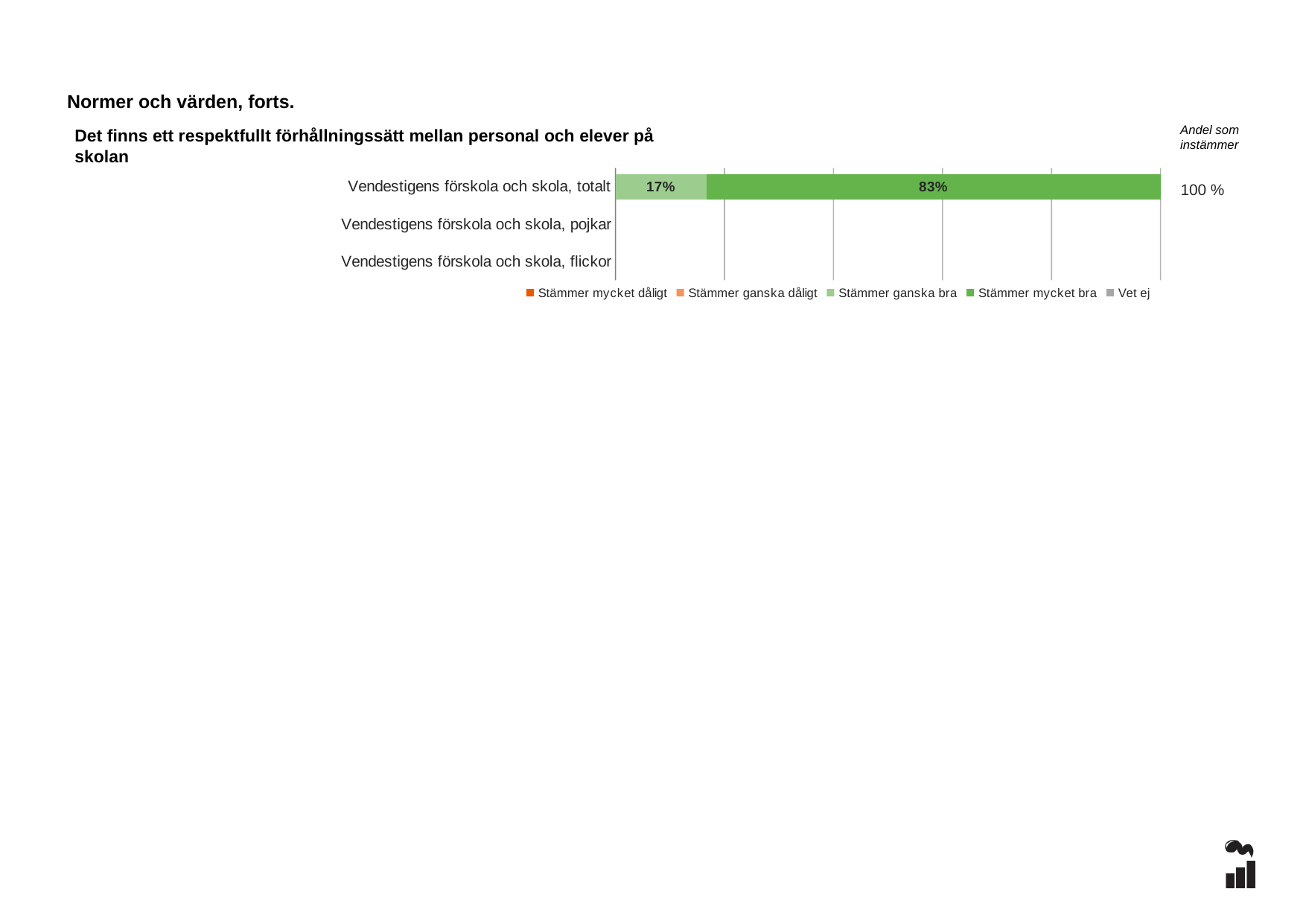
Which is larger for Vendestigens förskola och skola, totalt: "Stämmer ganska bra" or "Stämmer mycket bra"? Stämmer mycket bra What is the total of the stacked bar for Vendestigens förskola och skola, totalt? 100% What is the value for "Stämmer ganska bra" for Vendestigens förskola och skola, totalt? 17% What is the value for "Stämmer mycket bra" for Vendestigens förskola och skola, totalt? 83% How many categories are shown on the vertical axis of the chart? 3 What is the difference between the "Stämmer mycket bra" and "Stämmer ganska bra" values for Vendestigens förskola och skola, totalt? 66% Which legend entry is shown in the darkest green colour? Stämmer mycket bra What is the title of the chart? Det finns ett respektfullt förhållningssätt mellan personal och elever på skolan What kind of chart is shown on the slide? bar chart Which category has the largest "Stämmer mycket bra" segment? Vendestigens förskola och skola, totalt How many series does the legend list? 5 What is the "Andel som instämmer" value shown for Vendestigens förskola och skola, totalt? 100 %